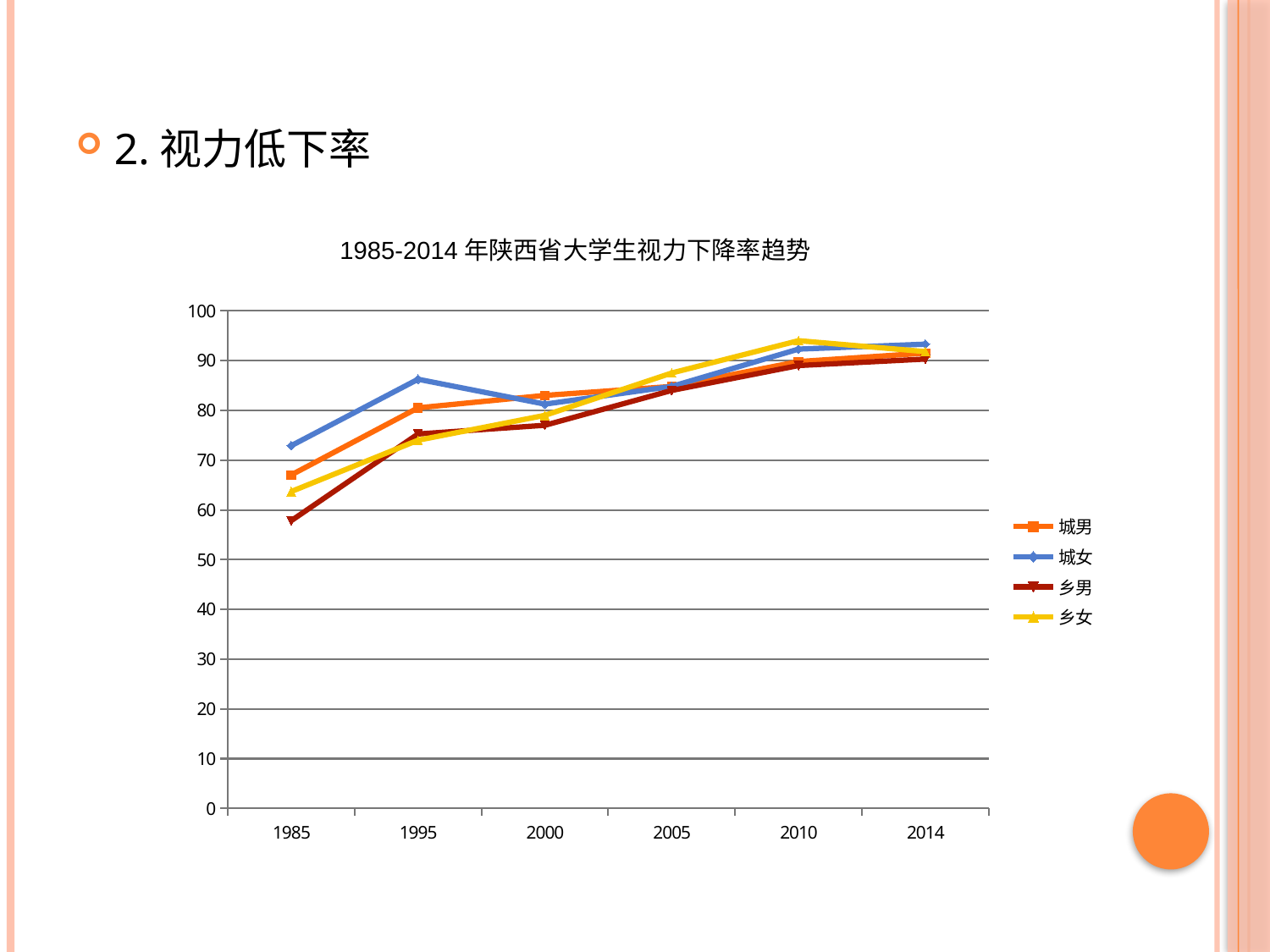
Is the value for 乡男 in 1985 greater or less than 60? less Is the value for 城女 in 1995 greater or less than 80? greater How many series does the legend list? 4 Which series has the lowest value in 1985? 乡男 Does the value for 城男 rise or fall from 1985 to 2014? rise Which series has the highest value in 1985? 城女 What kind of chart is shown on the slide? line chart In 2000, which is larger, the value for 城男 or the value for 乡男? 城男 What is the title of the chart? 1985-2014 年陕西省大学生视力下降率趋势 Is the value for 城男 in 1985 greater or less than 70? less Which series has the highest value in 1995? 城女 How many years are shown along the x axis? 6